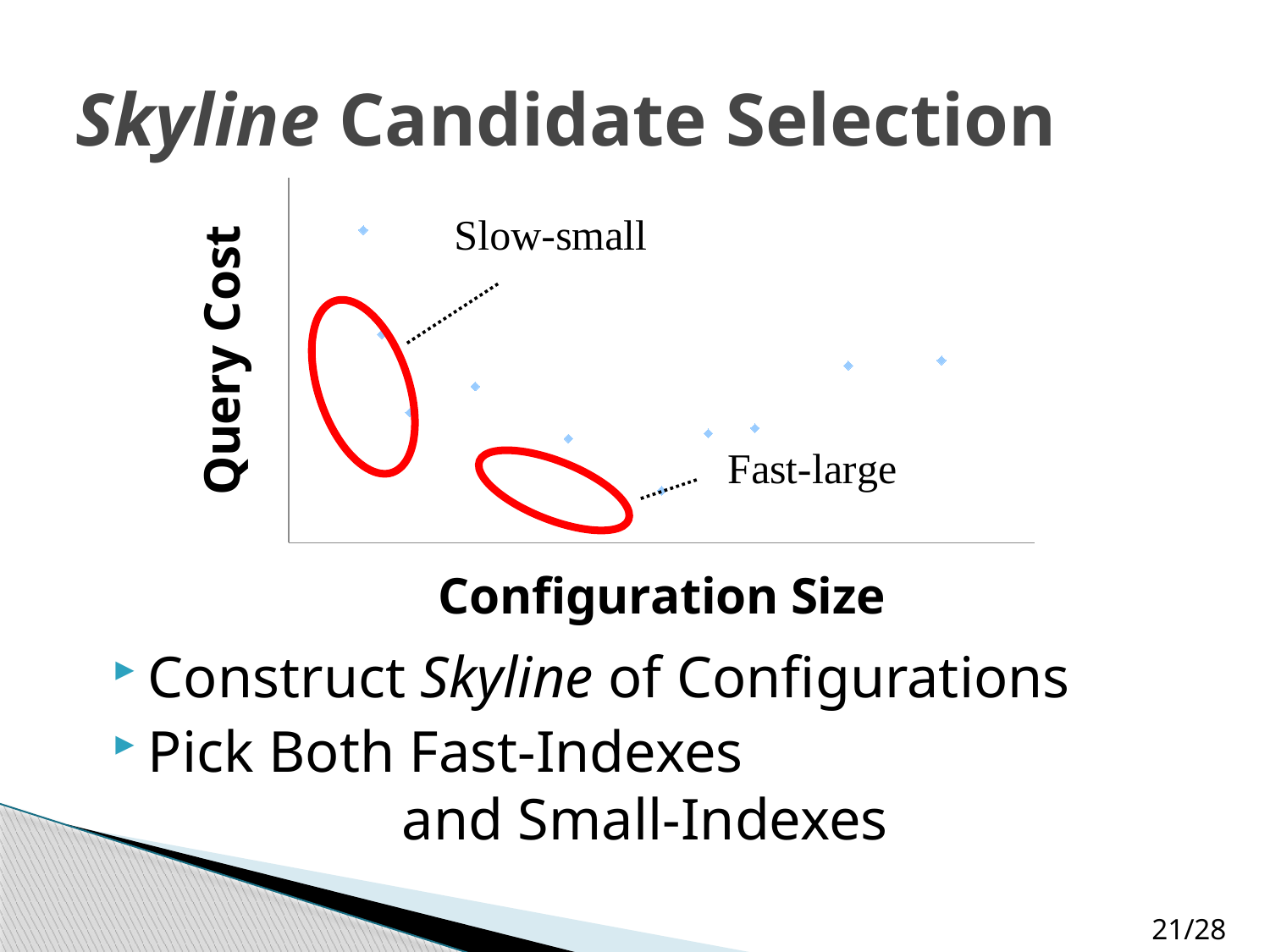
What kind of chart is shown on the slide? scatter chart Which annotation labels the group of points circled near the bottom middle of the chart? Fast-large Moving from the leftmost point to the points in the bottom-middle circle, does query cost rise or fall? fall Which annotation labels the group of points circled on the left side of the chart? Slow-small Does the query cost of the leftmost point appear higher or lower than the query cost of the rightmost point? higher What is the label of the vertical axis of the chart? Query Cost What is the label of the horizontal axis of the chart? Configuration Size How many data points are plotted in the chart? 10